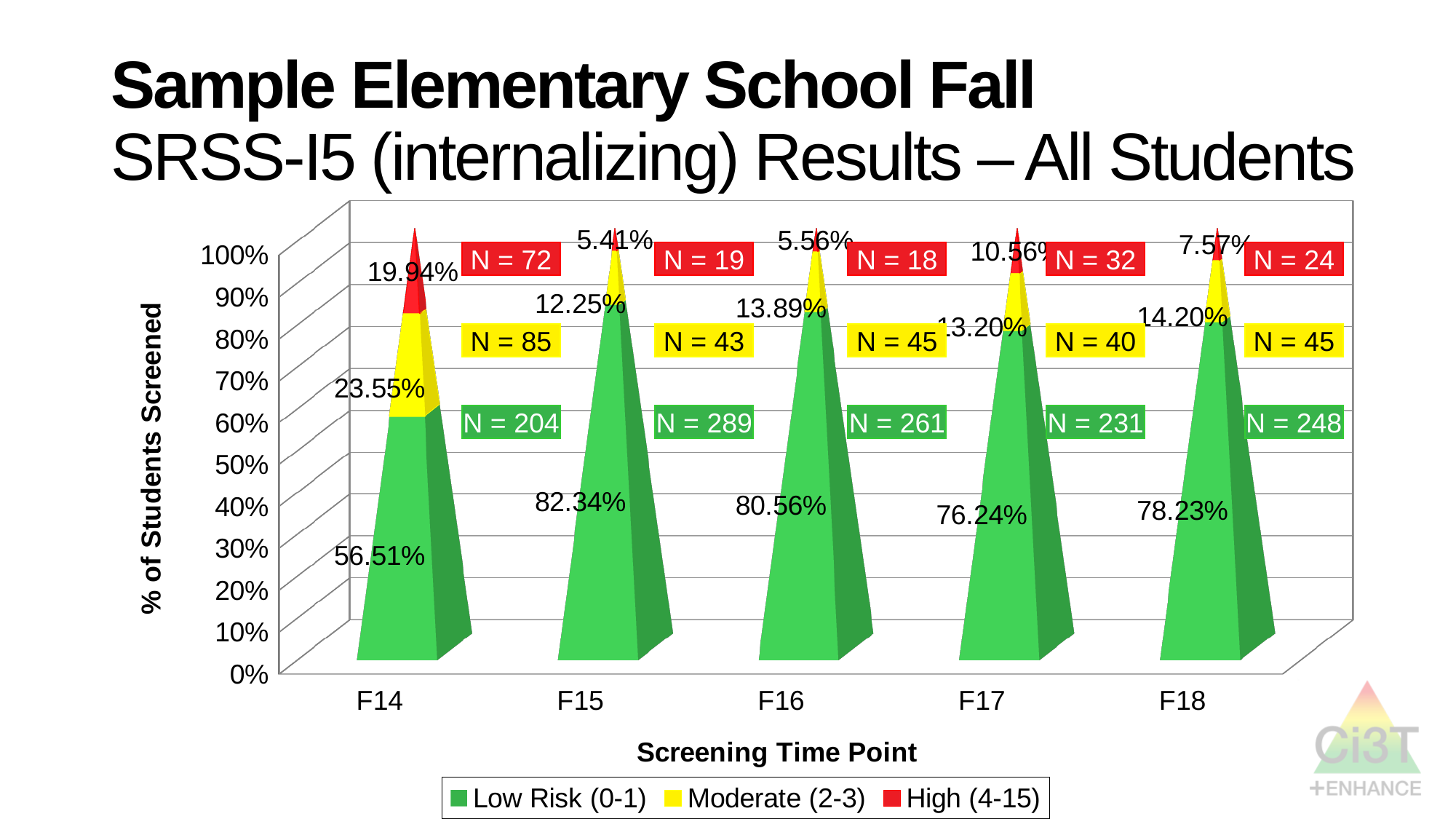
What percentage of students were Low Risk (0-1) at F14? 56.51% How many screening time points are shown on the x axis? 5 What is the difference between the Low Risk (0-1) percentage at F15 and at F14? 25.83% Which screening time point has the highest High (4-15) percentage? F14 What percentage of students were Moderate (2-3) at F18? 14.20% How many series does the legend list? 3 Which screening time point has the lowest Low Risk (0-1) percentage? F14 What is the N value shown for the Low Risk (0-1) group at F15? N = 289 Is the Moderate (2-3) percentage larger at F16 or at F17? F16 What percentage of students were High (4-15) at F17? 10.56% What kind of chart is shown on the slide? Stacked bar chart Which screening time point has the highest Low Risk (0-1) percentage? F15